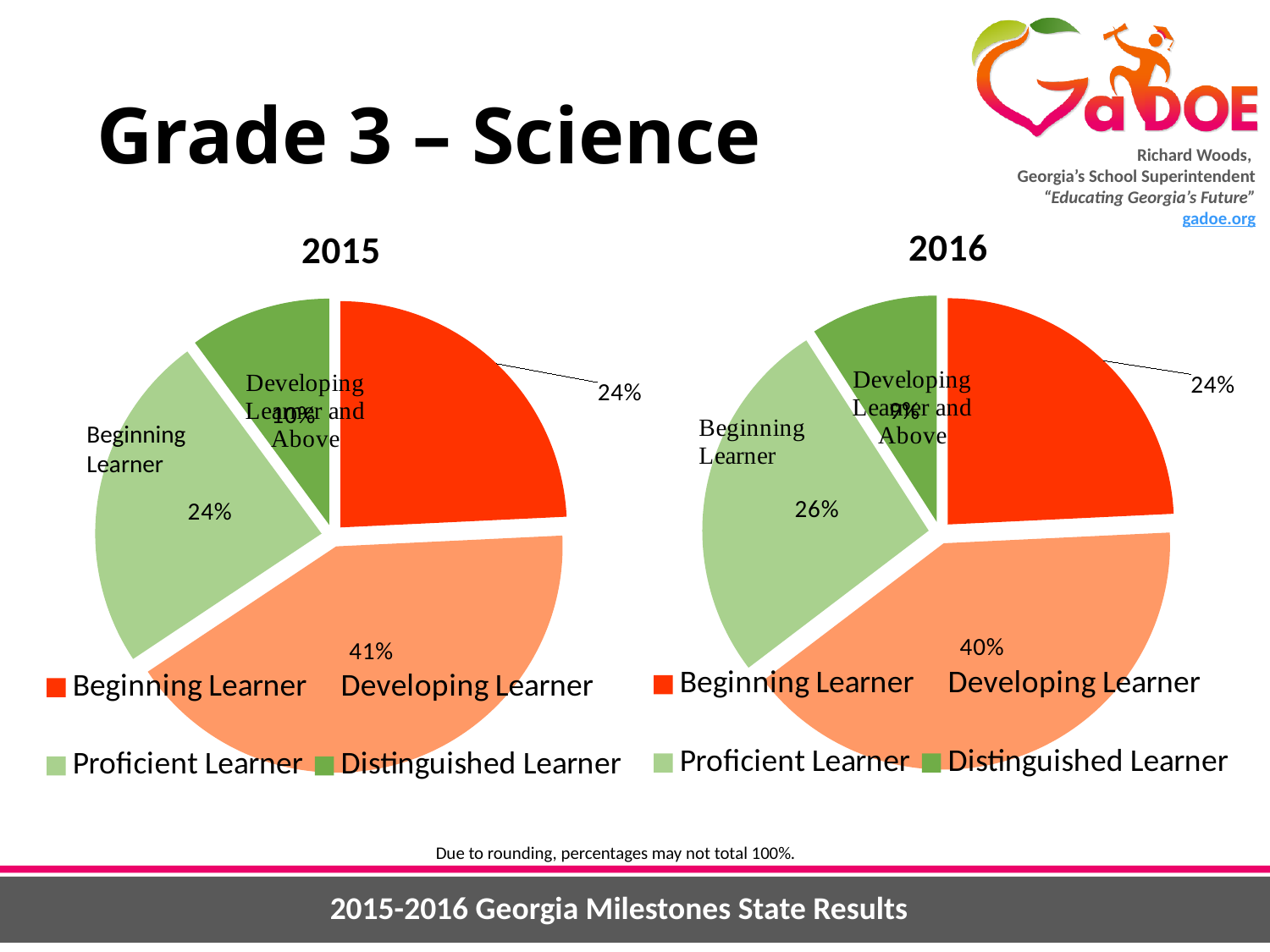
In the 2015 pie chart, what percentage is shown for Beginning Learner? 24% In the 2016 pie chart, what percentage is shown for Developing Learner? 40% In the 2015 pie chart, what percentage is shown for Developing Learner? 41% In the 2016 pie chart, which category has the smallest share? Distinguished Learner How many categories does the legend of each pie chart list? 4 What kind of charts are shown on the slide? Pie charts In the legend, what colour represents Beginning Learner? Red In the 2015 pie chart, which category has the largest share? Developing Learner Is the Developing Learner share larger in the 2015 pie chart or the 2016 pie chart? 2015 In the 2016 pie chart, what percentage is shown for Proficient Learner? 26% In the 2016 pie chart, what is the difference between the Developing Learner and Proficient Learner percentages? 14 percentage points In the 2015 pie chart, what percentage is shown for Distinguished Learner? 10%